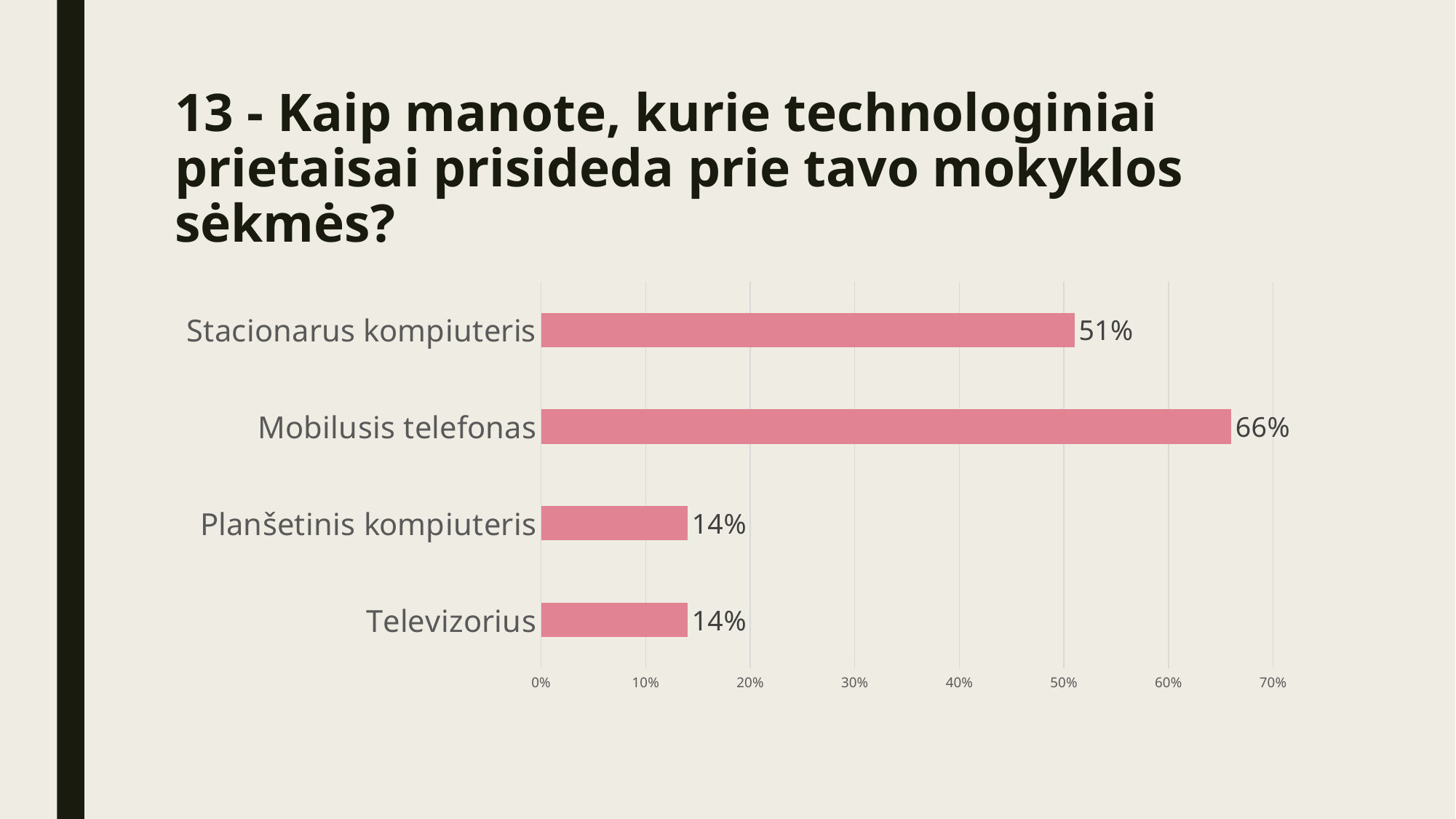
What is the value for Planšetinis kompiuteris? 14% Which category has the highest value? Mobilusis telefonas What is the value for Televizorius? 14% How many categories are shown in the chart? 4 What is the highest value shown on the horizontal axis? 70% What is the difference between the values for Stacionarus kompiuteris and Televizorius? 37% Which is larger, the value for Stacionarus kompiuteris or the value for Planšetinis kompiuteris? Stacionarus kompiuteris Is the value for Mobilusis telefonas greater or less than 60%? greater What kind of chart is shown on the slide? bar chart What is the value for Mobilusis telefonas? 66% What is the value for Stacionarus kompiuteris? 51% What is the difference between the values for Mobilusis telefonas and Stacionarus kompiuteris? 15%